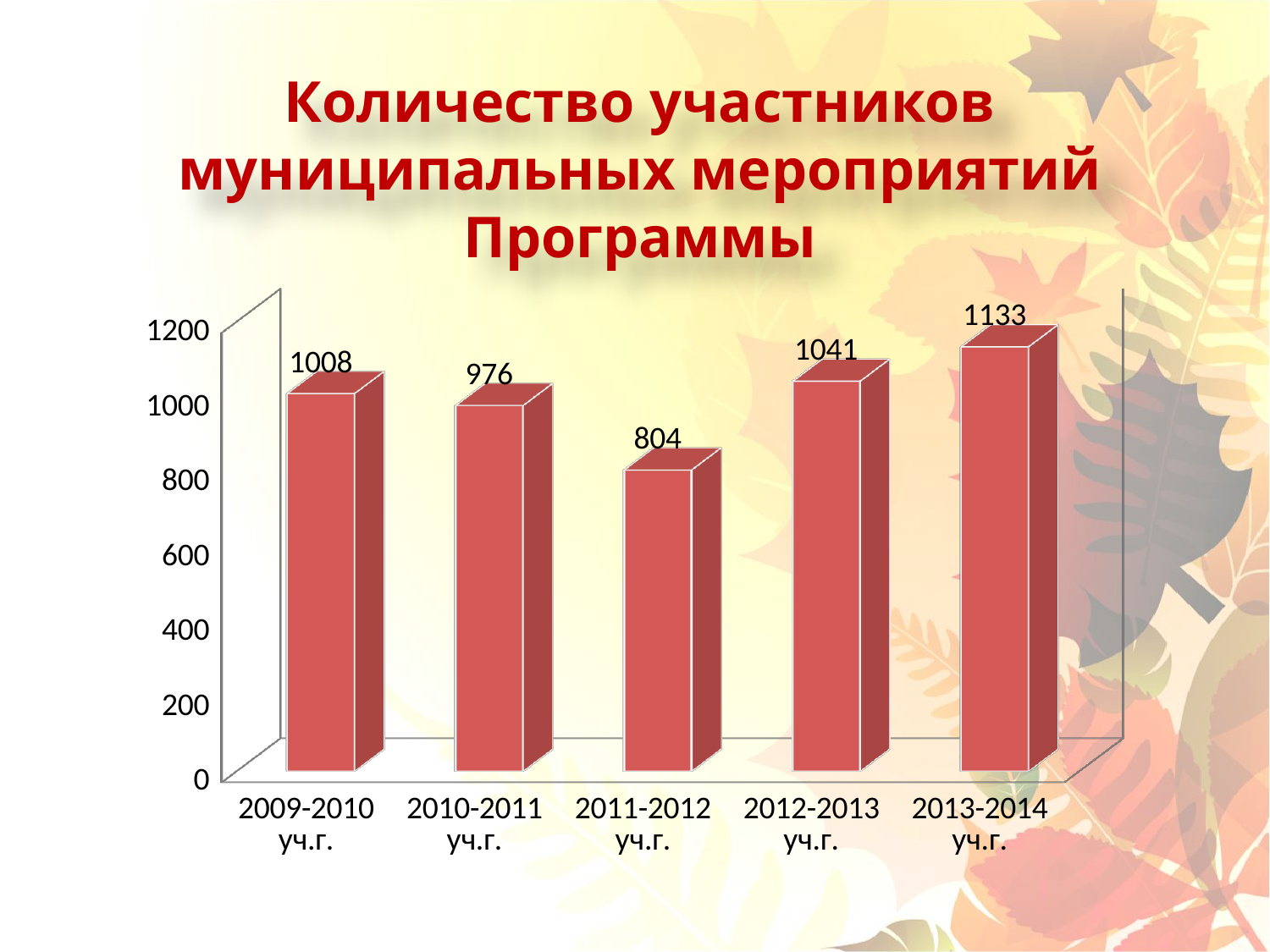
What is the value for 2013-2014 уч.г.? 1133 What is the difference between the values for 2009-2010 уч.г. and 2010-2011 уч.г.? 32 What is the value for 2011-2012 уч.г.? 804 What is the value for 2009-2010 уч.г.? 1008 Is the value for 2011-2012 уч.г. greater or less than 1000? less What is the difference between the values for 2013-2014 уч.г. and 2011-2012 уч.г.? 329 Which is larger, the value for 2012-2013 уч.г. or 2010-2011 уч.г.? 2012-2013 уч.г. Which academic year has the highest number of participants? 2013-2014 уч.г. What is the title of the chart on the slide? Количество участников муниципальных мероприятий Программы What kind of chart is shown on the slide? bar chart Which academic year has the lowest number of participants? 2011-2012 уч.г. How many academic years are shown on the chart? 5